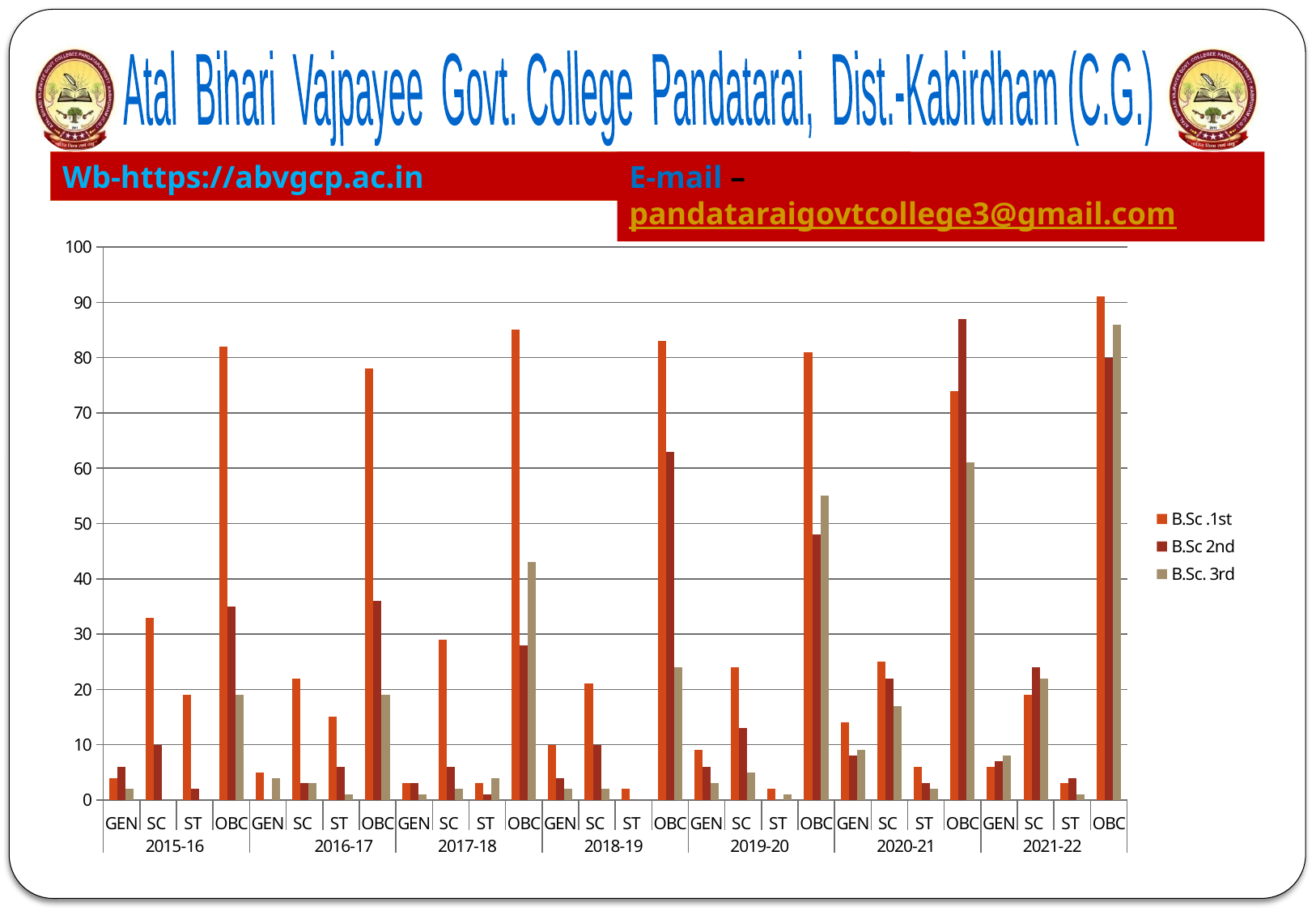
Which bar is the tallest in the whole chart? B.Sc .1st, OBC, 2021-22 Is the B.Sc .1st value for OBC in 2016-17 greater or less than 80? less For OBC in 2015-16, which is larger: the B.Sc .1st value or the B.Sc 2nd value? B.Sc .1st Which category groups appear under each academic year on the x axis? GEN, SC, ST, OBC Is the B.Sc. 3rd value for OBC in 2019-20 greater or less than 50? greater Is the B.Sc .1st value for OBC in 2021-22 greater or less than 80? greater In which academic year is the B.Sc. 3rd value for OBC the highest? 2021-22 How many academic years are shown along the x axis? 7 How many series does the legend list? 3 What are the three series named in the legend? B.Sc .1st, B.Sc 2nd, B.Sc. 3rd What kind of chart is shown on the slide? bar chart